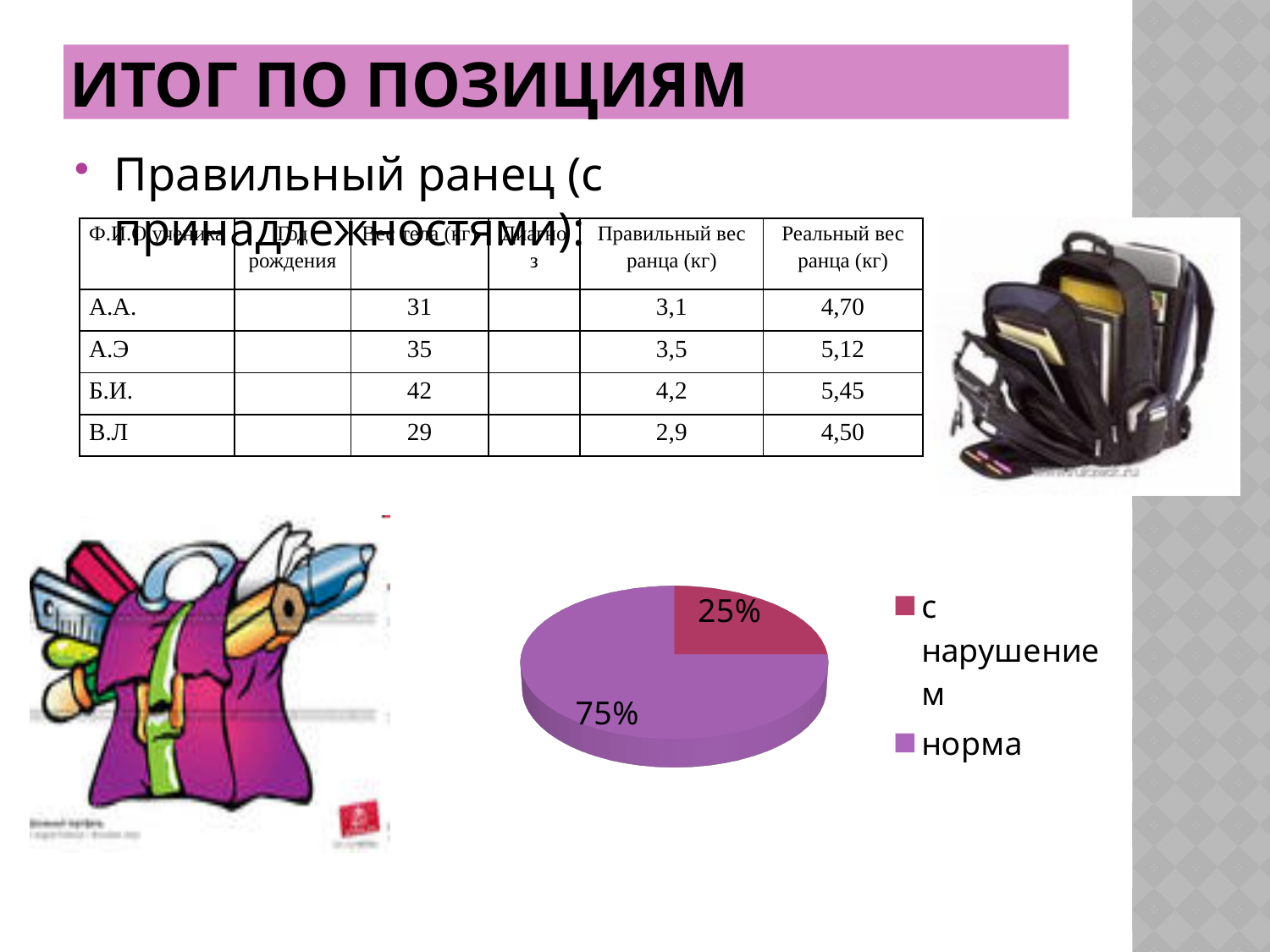
What share of the pie chart does the "норма" slice represent? 75% What value is shown for the "норма" category in the pie chart? 75% What value is shown for the "с нарушением" category in the pie chart? 25% What kind of chart is shown on the slide? Pie chart How many entries does the legend of the pie chart list? 2 How many slices does the pie chart have? 2 Which category has the smallest slice in the pie chart? с нарушением What is the difference in percentage points between the "норма" and "с нарушением" slices? 50% Which slice is larger in the pie chart, "норма" or "с нарушением"? норма What share of the pie chart does the "с нарушением" slice represent? 25% Which legend entry is shown in the darker red-pink colour in the pie chart? с нарушением Which category has the largest slice in the pie chart? норма